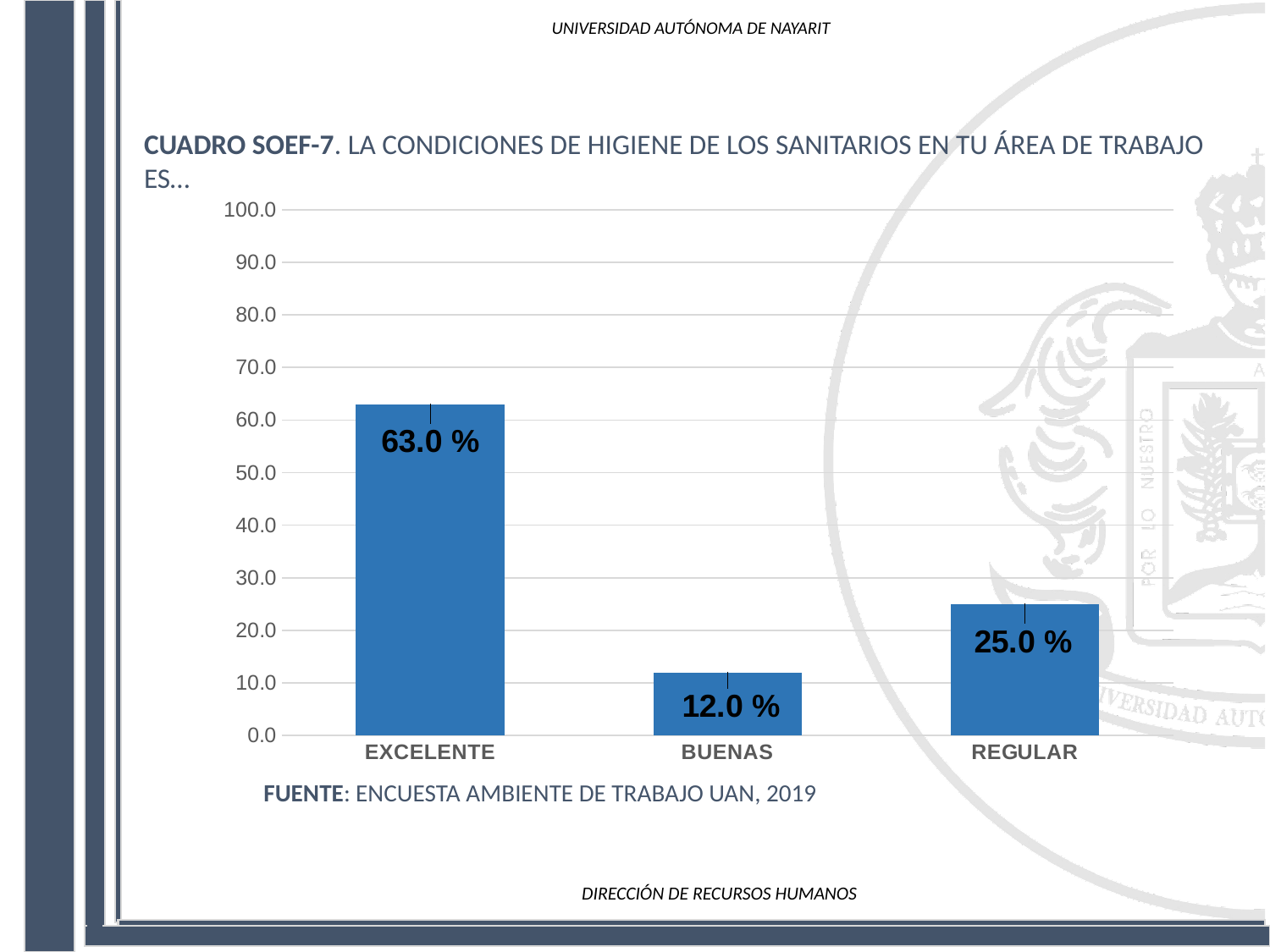
What is the difference between the values for EXCELENTE and REGULAR? 38.0 % Which category has the lowest value? BUENAS What is the value for BUENAS? 12.0 % What source is cited below the chart? ENCUESTA AMBIENTE DE TRABAJO UAN, 2019 Which category has the highest value? EXCELENTE What kind of chart is shown on the slide? bar chart What is the value for EXCELENTE? 63.0 % Is the value for EXCELENTE greater or less than 50.0? greater Which is larger, the value for REGULAR or the value for BUENAS? REGULAR What is the difference between the values for REGULAR and BUENAS? 13.0 % What is the value for REGULAR? 25.0 % How many categories are shown on the x axis? 3